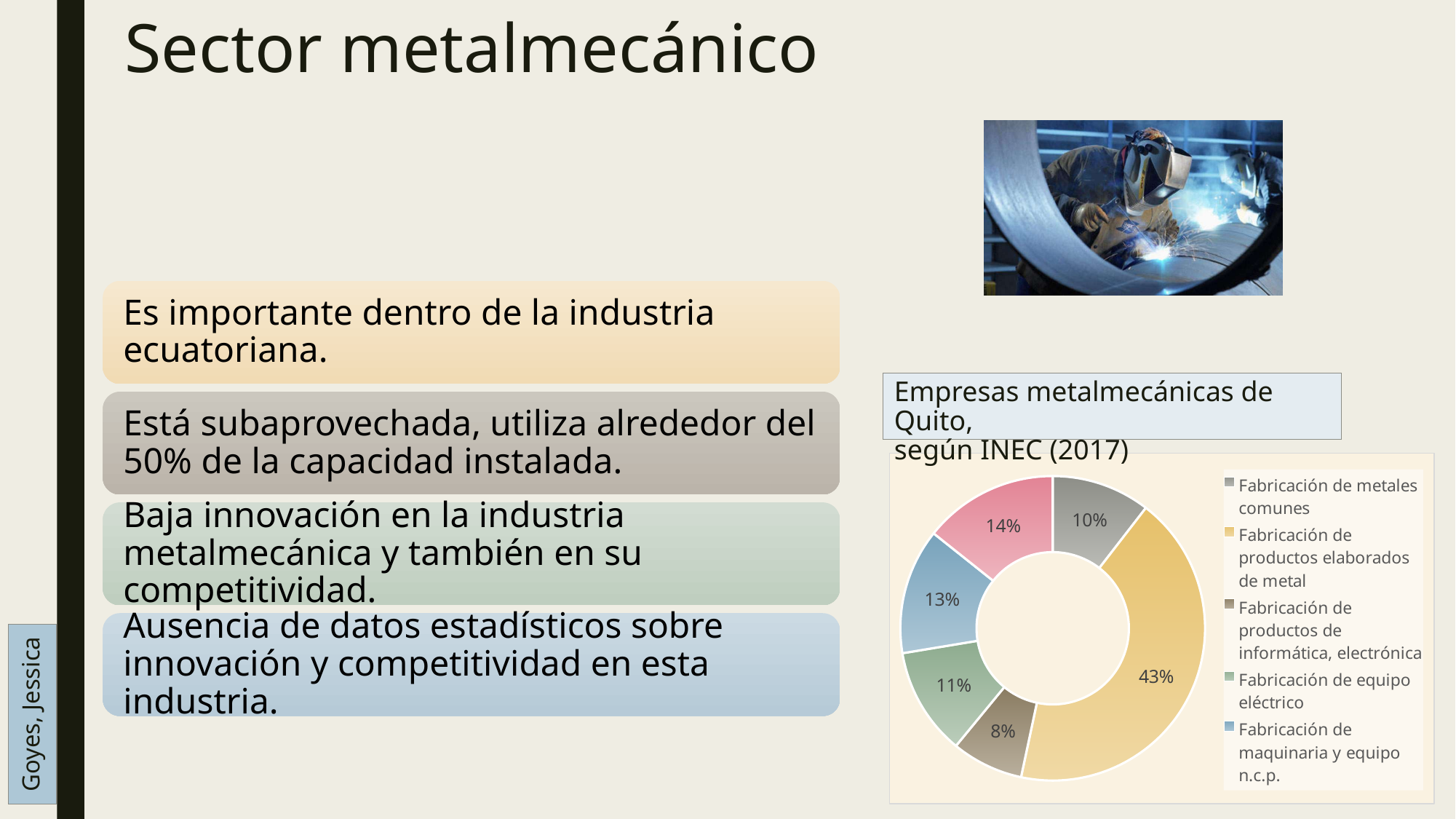
What percentage of the chart corresponds to Fabricación de productos elaborados de metal? 43% What percentage is shown for Fabricación de productos de informática, electrónica? 8% Which category has the largest share of the chart? Fabricación de productos elaborados de metal What percentage is shown for Fabricación de equipo eléctrico? 11% What percentage is shown for Fabricación de maquinaria y equipo n.c.p.? 13% What is the difference in percentage points between Fabricación de productos elaborados de metal and Fabricación de metales comunes? 33 percentage points What percentage is shown for Fabricación de metales comunes? 10% What kind of chart is shown on the slide? Doughnut (pie) chart Which category has the smallest share of the chart? Fabricación de productos de informática, electrónica Which is larger: the share for Fabricación de equipo eléctrico or for Fabricación de maquinaria y equipo n.c.p.? Fabricación de maquinaria y equipo n.c.p. What is the title of the chart? Empresas metalmecánicas de Quito, según INEC (2017) How many slices does the chart have? 6